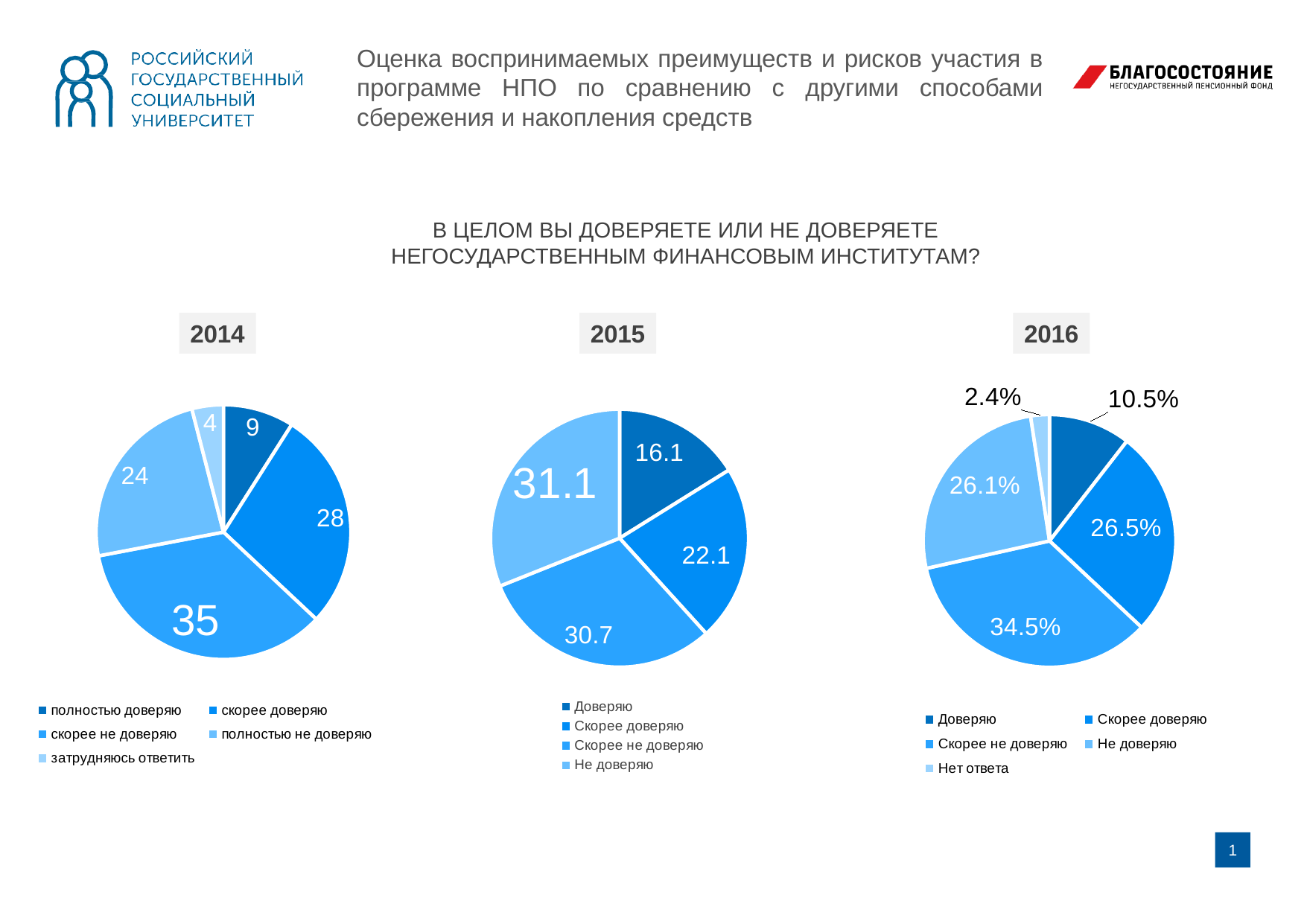
In the 2016 pie chart, what is the value for "Доверяю"? 10.5% In the 2016 pie chart, which category has the largest slice? Скорее не доверяю In the 2015 pie chart, how many categories are shown? 4 In the 2016 pie chart, what is the difference between "Скорее не доверяю" and "Не доверяю"? 8.4% In the 2014 pie chart, what is the value for "затрудняюсь ответить"? 4 In the 2015 pie chart, what is the value for "Скорее доверяю"? 22.1 What type of chart is used for the 2014, 2015 and 2016 data? Pie chart In the 2014 pie chart, what is the difference between "скорее не доверяю" and "полностью доверяю"? 26 In the 2016 pie chart, which is larger: "Скорее доверяю" or "Доверяю"? Скорее доверяю In the 2014 pie chart, which category has the smallest slice? затрудняюсь ответить In the 2014 pie chart, what is the value for "скорее не доверяю"? 35 In the 2015 pie chart, which category has the largest slice? Не доверяю